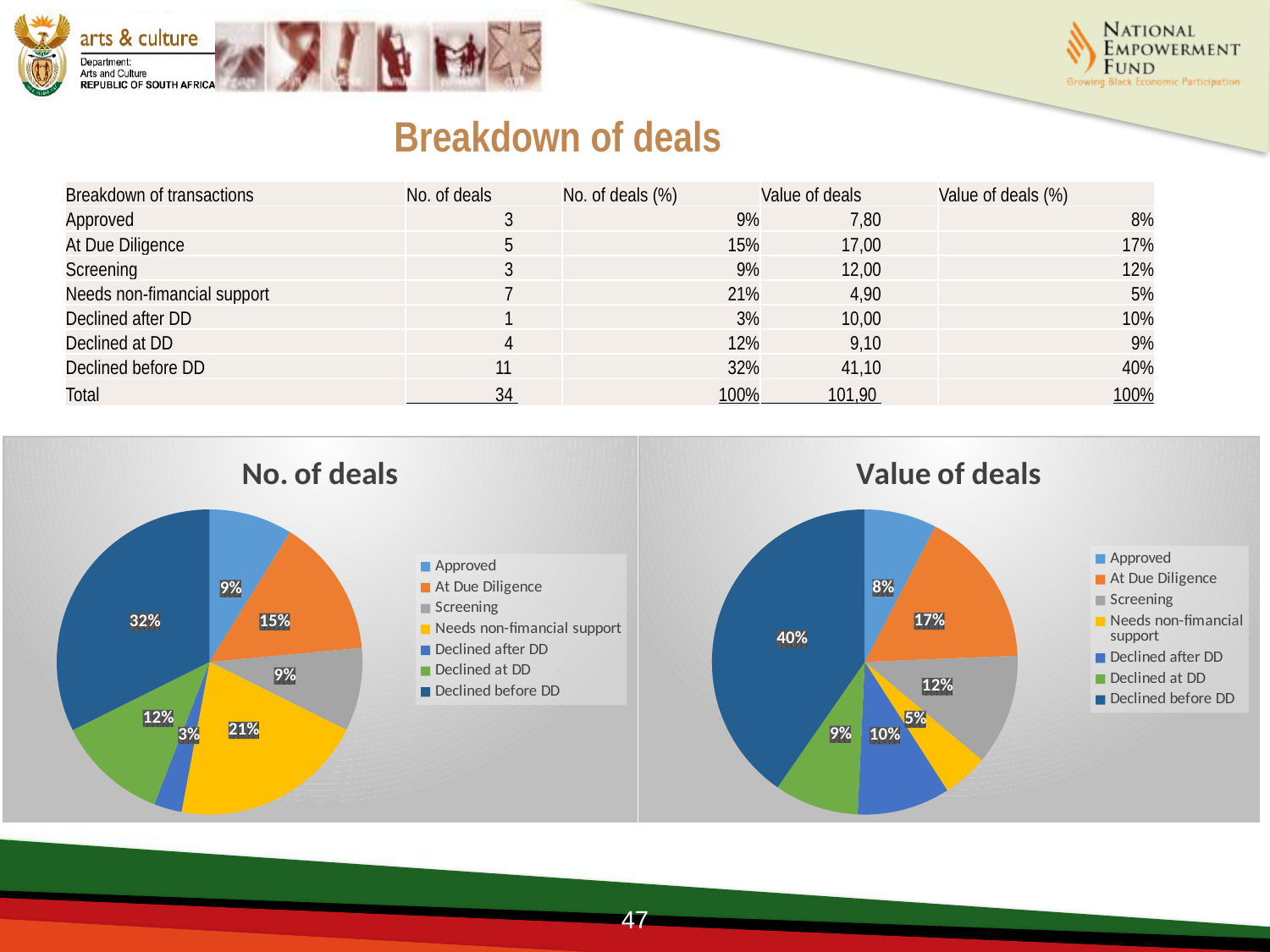
In the "Value of deals" chart, which is larger: the share for Screening or the share for Declined at DD? Screening In the "No. of deals" chart, what is the share for Needs non-financial support? 21% In the "Value of deals" chart, which category has the largest slice? Declined before DD In the "No. of deals" chart, which category has the smallest slice? Declined after DD In the "Value of deals" chart, what is the share for At Due Diligence? 17% In the "Value of deals" chart, which category has the smallest slice? Needs non-financial support In the "No. of deals" chart, what is the difference between the shares of Declined before DD and Needs non-financial support? 11% How many categories does the legend of the "No. of deals" chart list? 7 In the "Value of deals" chart, what share does Declined before DD have? 40% In the "No. of deals" chart, what share does Declined before DD have? 32% In the "No. of deals" chart, what colour is the Declined before DD slice? Dark blue What type of chart is the "Value of deals" chart? Pie chart